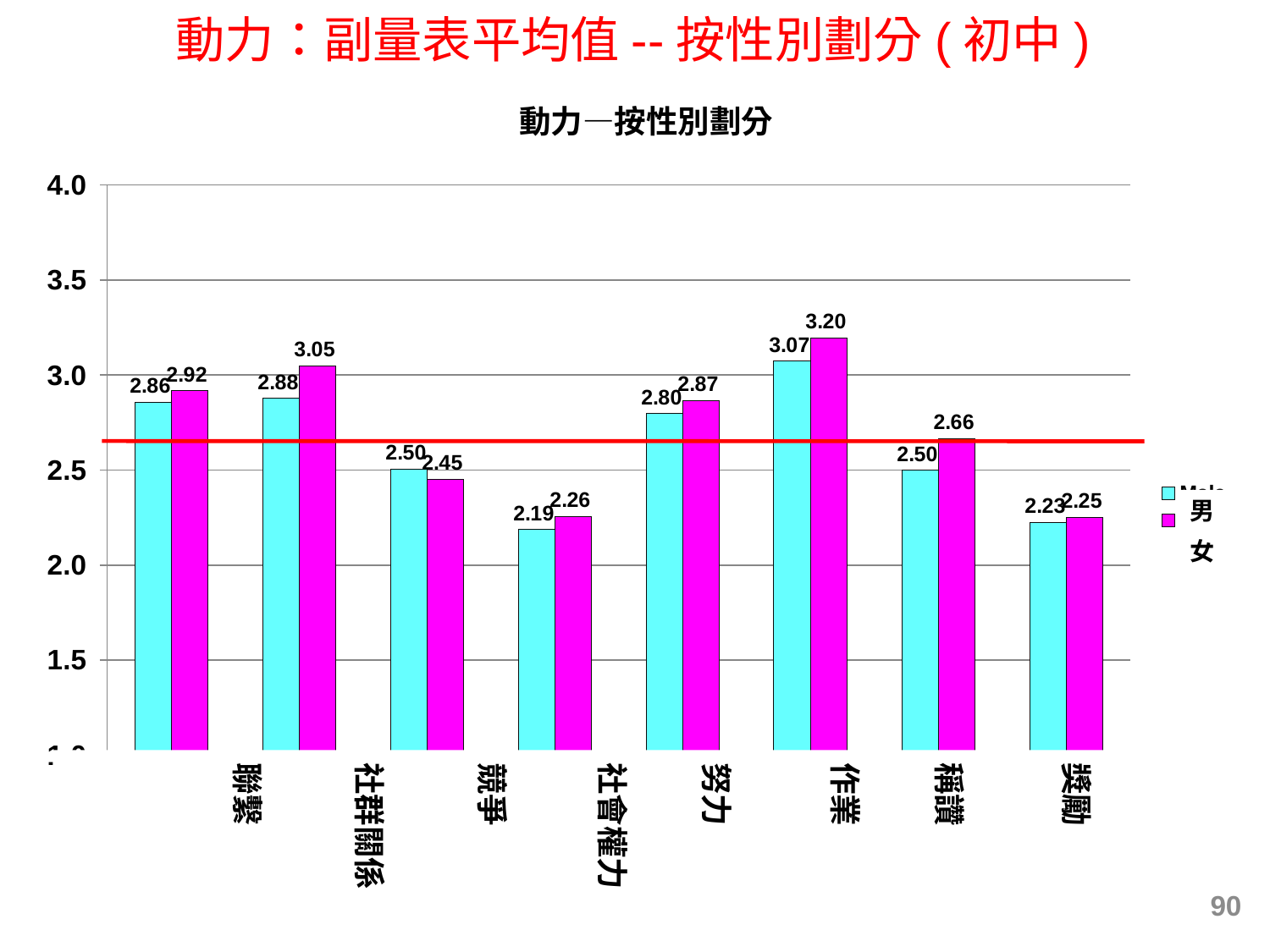
In the 競爭 category, which is larger, the 男 value or the 女 value? 男 What is the difference between the 女 and 男 values in the 稱讚 category? 0.16 What is the value for 男 in the 作業 category? 3.07 What is the value for 女 in the 社群關係 category? 3.05 How many categories are shown on the x axis? 8 Which category has the lowest value for 男? 社會權力 Is the value for 女 in the 努力 category greater or less than 2.5? greater What kind of chart is this? bar chart What is the value for 男 in the 社會權力 category? 2.19 What is the difference between the 女 and 男 values in the 作業 category? 0.13 Which category has the highest value for 女? 作業 What is the title of the chart? 動力─按性別劃分